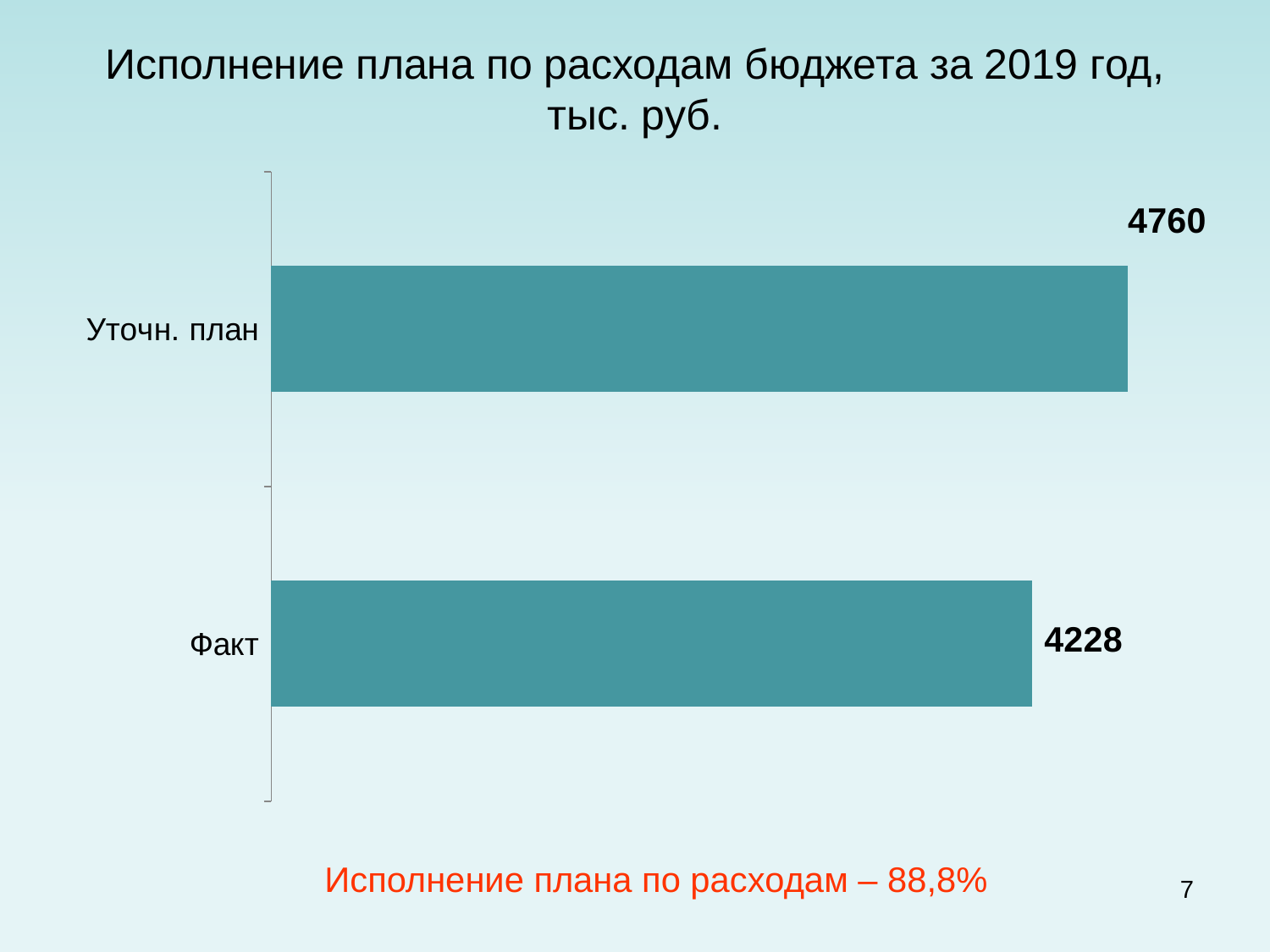
What kind of chart is shown on the slide? bar chart Which category has the highest value? Уточн. план What is the title of the slide containing the chart? Исполнение плана по расходам бюджета за 2019 год, тыс. руб. What percentage of plan execution for expenses is stated below the chart? 88,8% Which category has the lowest value? Факт What is the value for Факт? 4228 What is the difference between the values for Уточн. план and Факт? 532 How many categories are shown in the chart? 2 Which is larger, the value for Уточн. план or the value for Факт? Уточн. план What is the value for Уточн. план? 4760